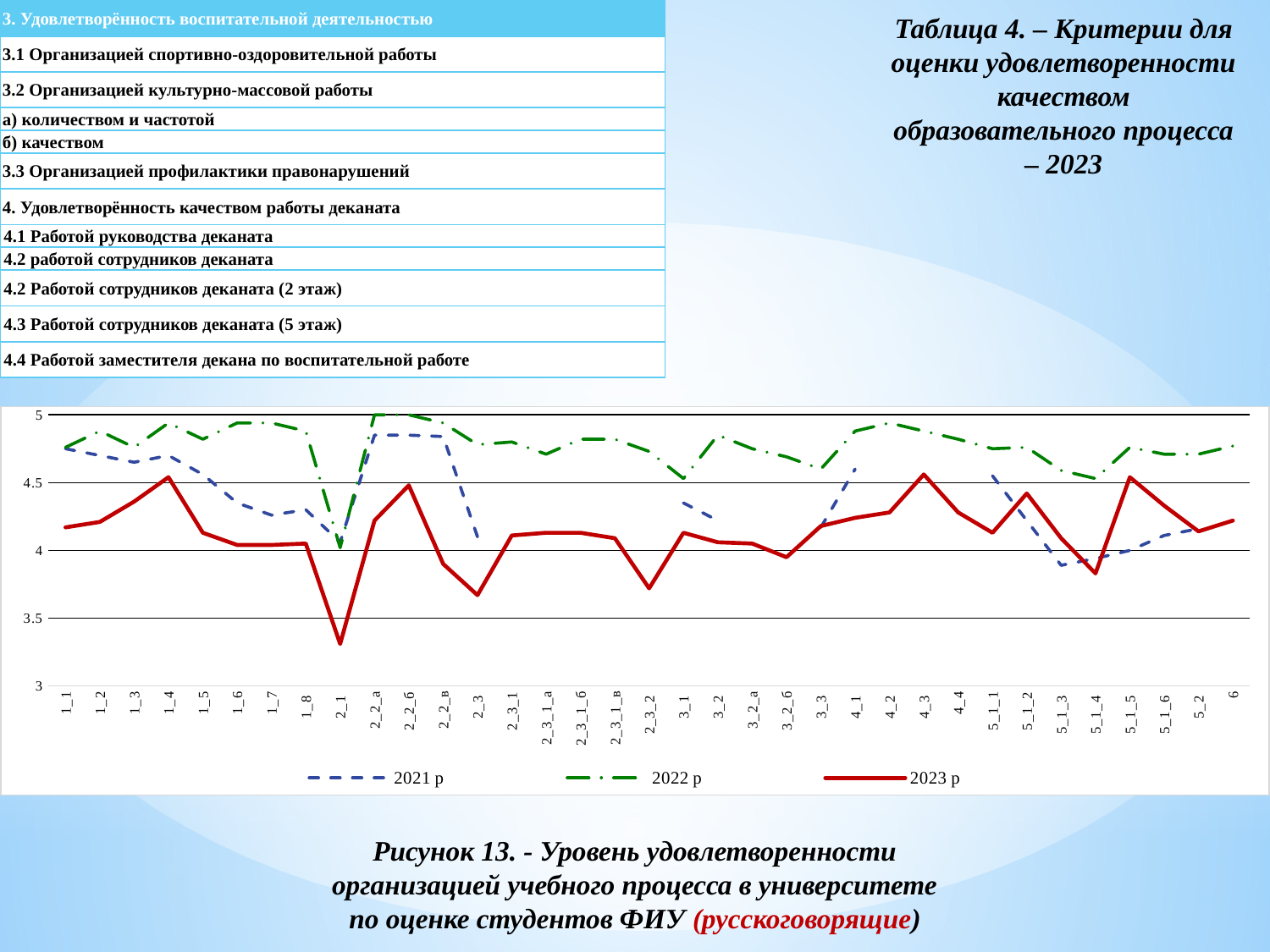
Which series is drawn as a solid red line? 2023 р How many series does the chart legend list? 3 Is the value of the 2022 р series at 2_2_а greater or less than 4.5? greater At category 1_1, which series has the larger value, 2022 р or 2023 р? 2022 р Is the value of the 2023 р series at 2_1 greater or less than 3.5? less Is the value of the 2021 р series at 1_1 greater or less than 4.5? greater For the 2023 р series, which category has the lowest value? 2_1 What kind of chart is shown on the slide? line chart Which series are listed in the chart legend? 2021 р, 2022 р, 2023 р At category 2_1, which series has the larger value, 2021 р or 2023 р? 2021 р How many categories are shown along the x axis of the chart? 35